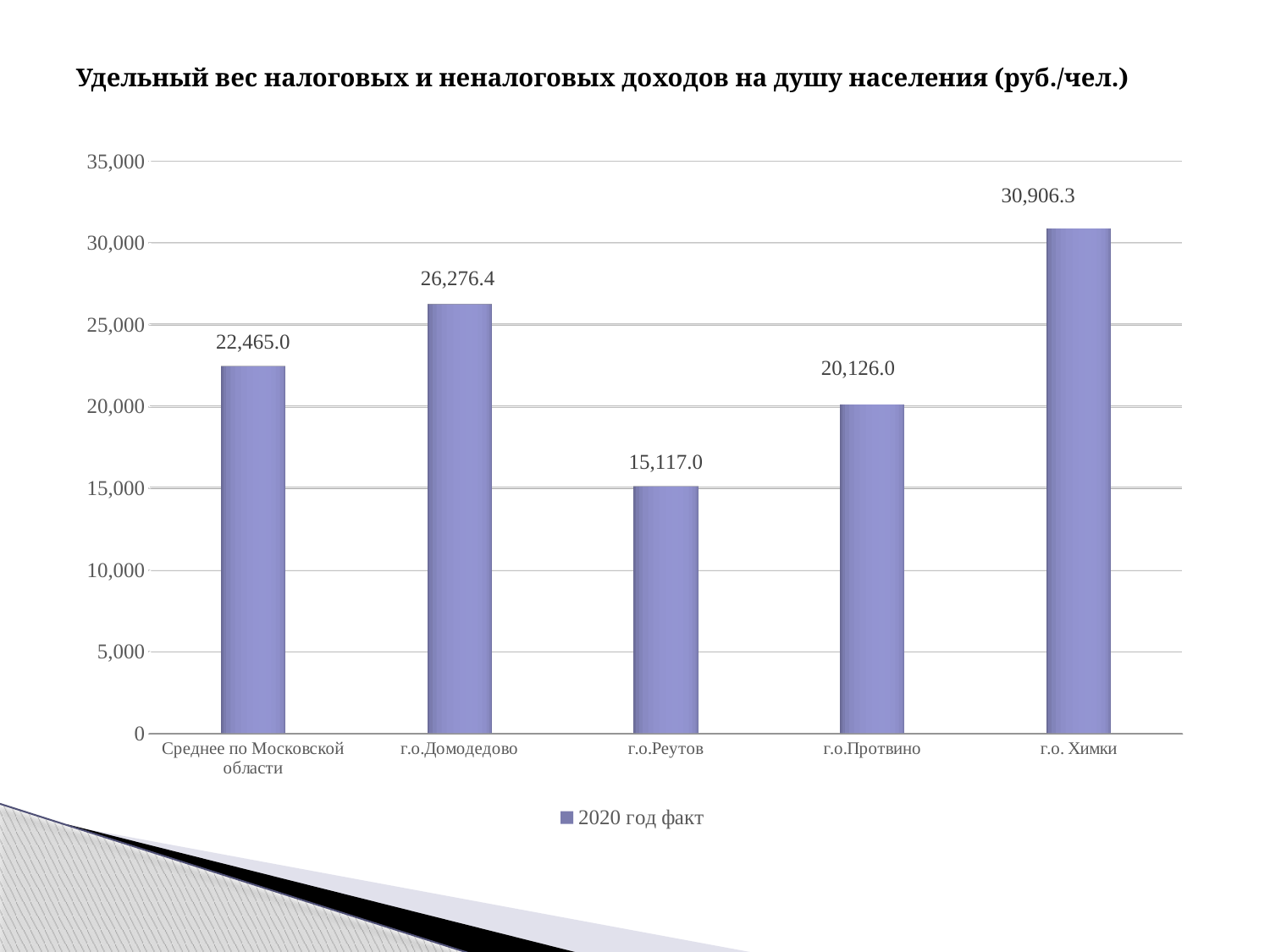
What is the value for г.о.Протвино? 20,126.0 Which category has the highest value? г.о. Химки What is the value for г.о.Реутов? 15,117.0 What is the difference between the values for г.о. Химки and г.о.Домодедово? 4,629.9 Which category has the lowest value? г.о.Реутов What is the difference between the values for Среднее по Московской области and г.о.Протвино? 2,339.0 How many series does the legend list? 1 What is the value for Среднее по Московской области? 22,465.0 What is the value for г.о. Химки? 30,906.3 What kind of chart is shown on the slide? bar chart Which is larger, the value for г.о.Домодедово or the value for Среднее по Московской области? г.о.Домодедово How many categories are shown on the x axis? 5